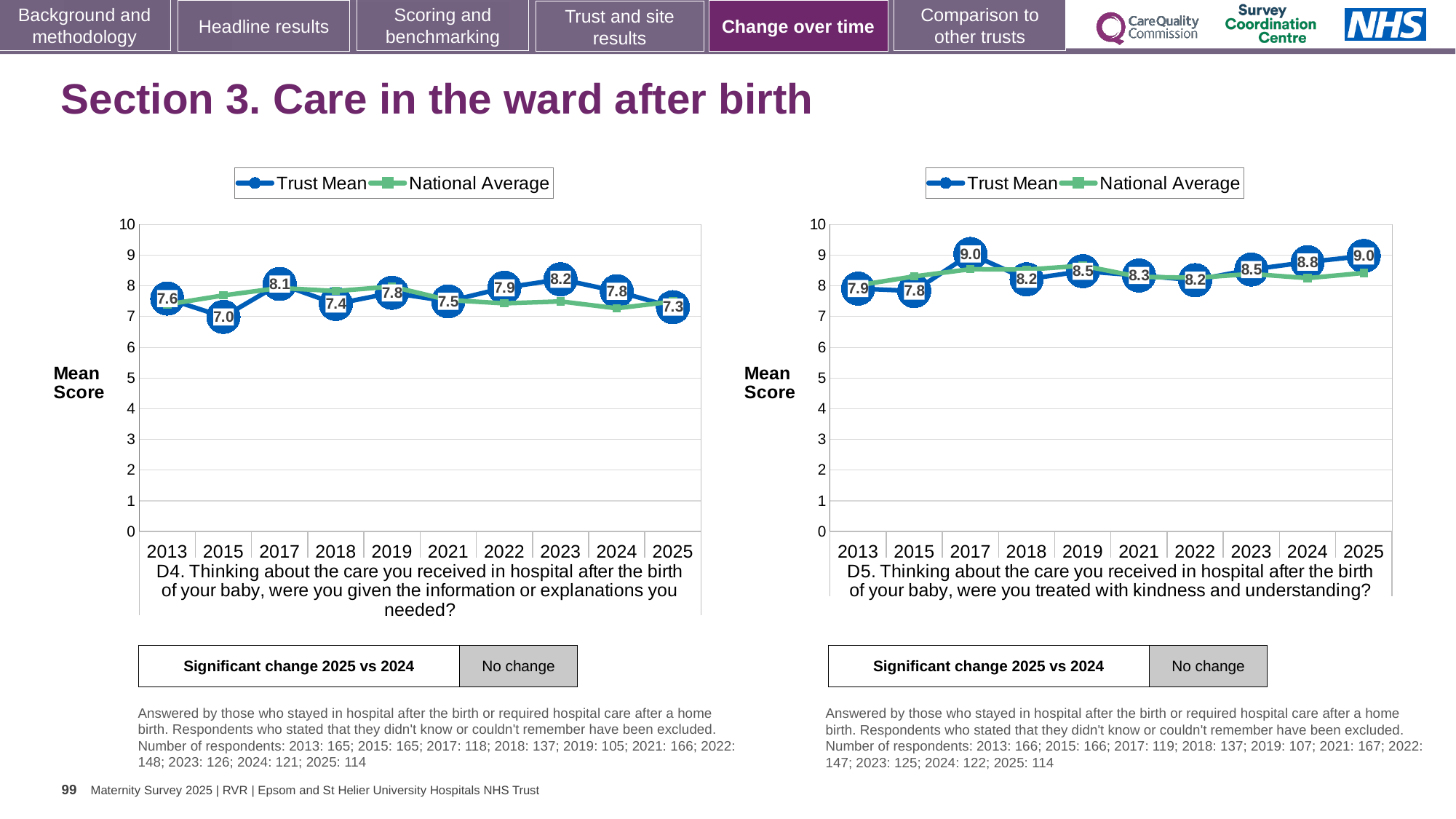
How many series does the legend of the right chart (D5) list? 2 In the right chart (D5), which year has the lowest Trust Mean score? 2015 How many years are plotted on the x axis of the left chart (D4)? 10 In the right chart (D5), what is the Trust Mean score for 2013? 7.9 In the left chart (D4), which is larger, the Trust Mean score for 2019 or for 2021? 2019 What kind of chart is the left chart (D4)? Line chart In the left chart (D4), what is the Trust Mean score for 2017? 8.1 In the left chart (D4), what is the Trust Mean score for 2025? 7.3 In the left chart (D4), which year has the lowest Trust Mean score? 2015 In the right chart (D5), what is the Trust Mean score for 2024? 8.8 In the right chart (D5), what is the difference between the Trust Mean scores for 2025 and 2013? 1.1 In the left chart (D4), which year has the highest Trust Mean score? 2023